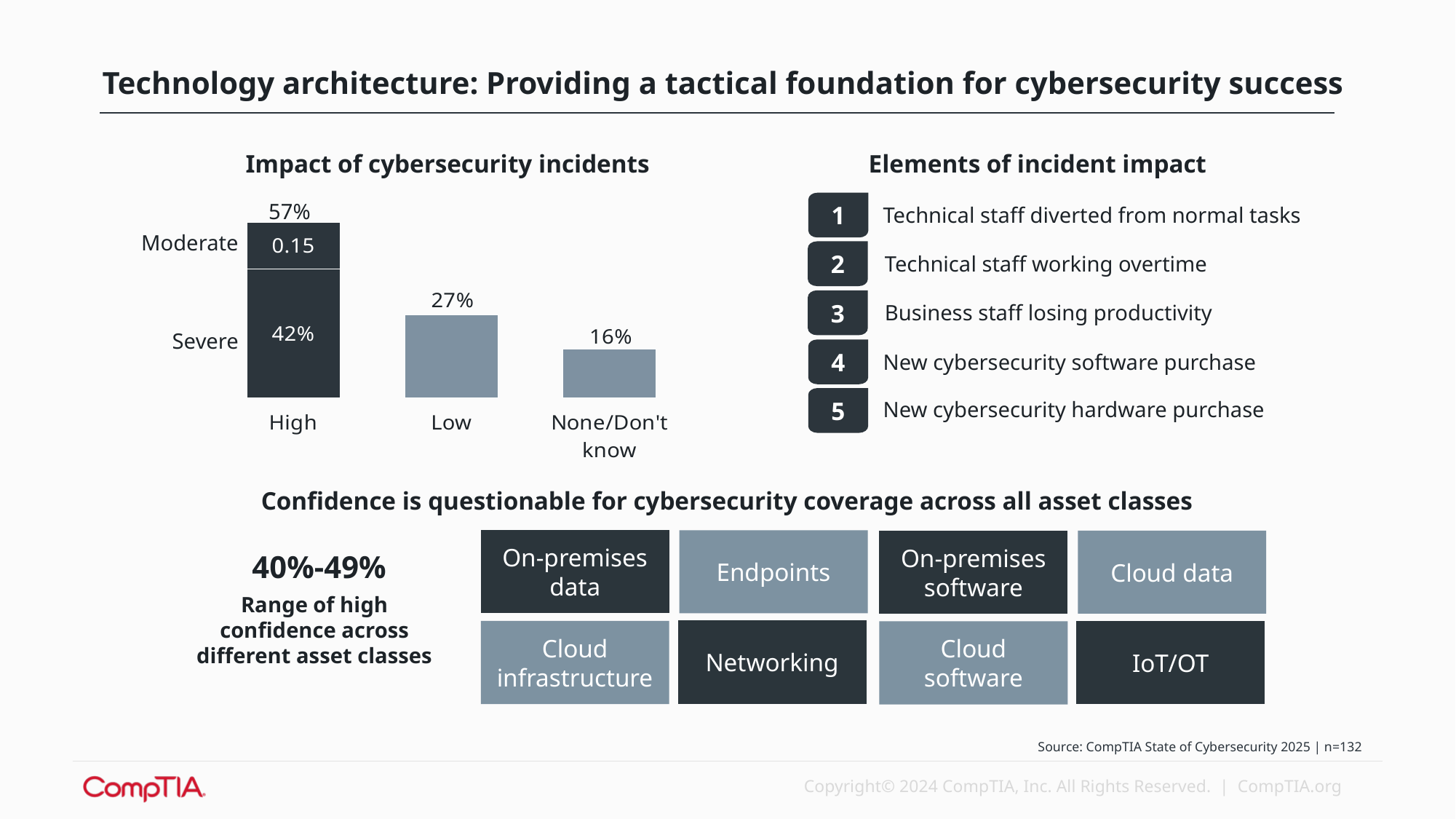
In the 'Impact of cybersecurity incidents' chart, which category has the lowest value? None/Don't know In the 'Impact of cybersecurity incidents' chart, what label is printed on the Moderate segment of the High bar? 0.15 In the 'Impact of cybersecurity incidents' chart, which is larger: Low or None/Don't know? Low In the 'Impact of cybersecurity incidents' chart, what is the value for None/Don't know? 16% In the 'Impact of cybersecurity incidents' chart, what is the difference between the Low value and the None/Don't know value? 11% How many categories are shown on the x axis of the 'Impact of cybersecurity incidents' chart? 3 In the 'Impact of cybersecurity incidents' chart, what is the total shown above the High bar? 57% In the 'Impact of cybersecurity incidents' chart, what is the difference between the High total and the Low value? 30% In the 'Impact of cybersecurity incidents' chart, what is the value for Low? 27% What kind of chart is 'Impact of cybersecurity incidents'? Bar chart In the 'Impact of cybersecurity incidents' chart, what is the value of the Severe segment of the High bar? 42% In the 'Impact of cybersecurity incidents' chart, which category has the highest value? High